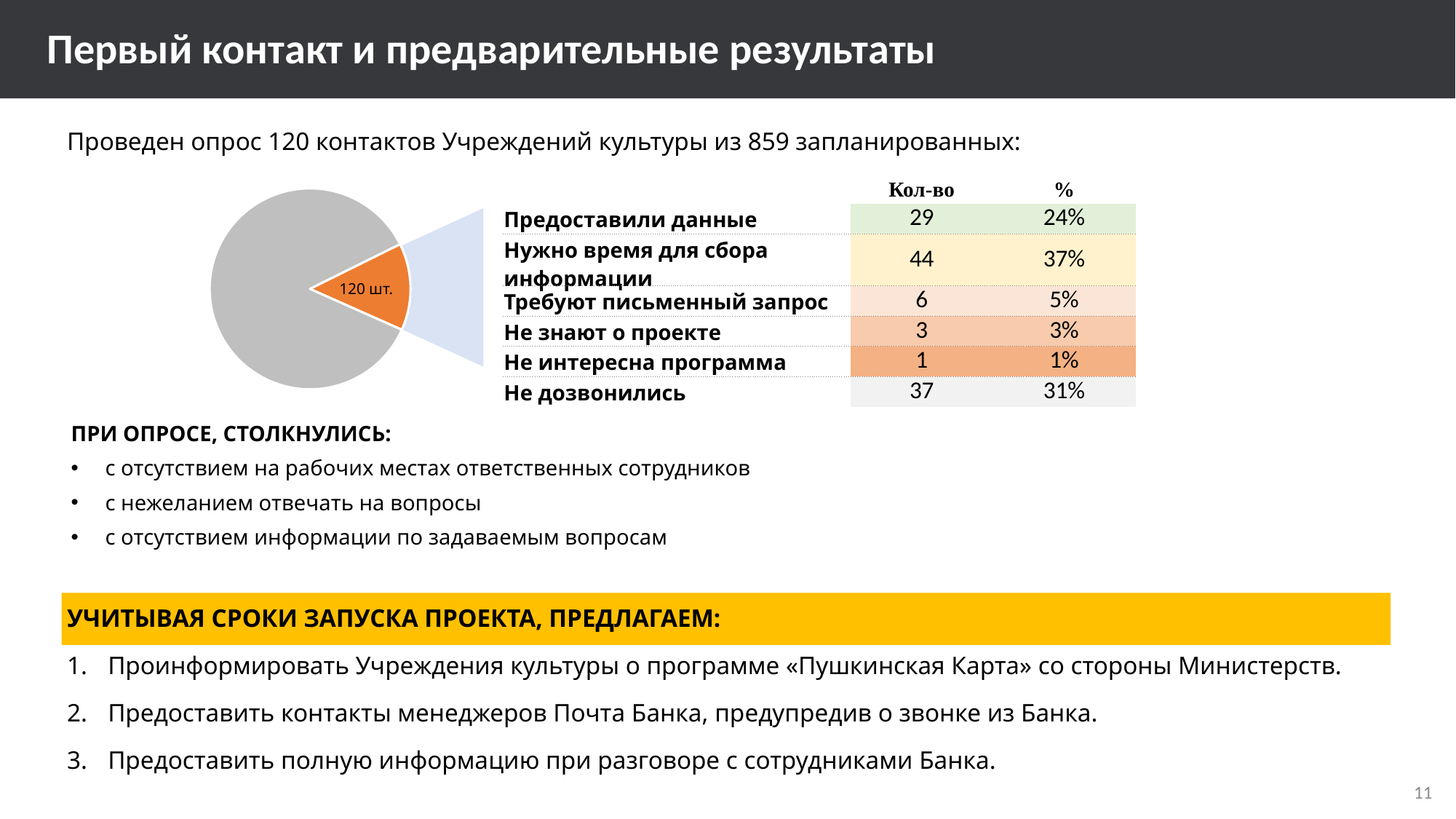
What kind of chart is shown on the slide? pie chart In the breakdown table next to the pie chart, what is the Кол-во value for Требуют письменный запрос? 6 In the breakdown table next to the pie chart, what percentage is shown for Не дозвонились? 31% In the breakdown table next to the pie chart, what percentage is shown for Нужно время для сбора информации? 37% Which slice of the pie chart is larger, the grey one or the orange one? the grey one In the breakdown table next to the pie chart, which category has the highest Кол-во? Нужно время для сбора информации In the breakdown table next to the pie chart, which category has the lowest Кол-во? Не интересна программа How many slices does the pie chart have? 2 What label is printed on the orange slice of the pie chart? 120 шт. In the breakdown table next to the pie chart, what is the Кол-во value for Предоставили данные? 29 What colour is the highlighted slice of the pie chart that is broken out into the table? orange In the breakdown table next to the pie chart, what is the difference in Кол-во between Не дозвонились and Предоставили данные? 8